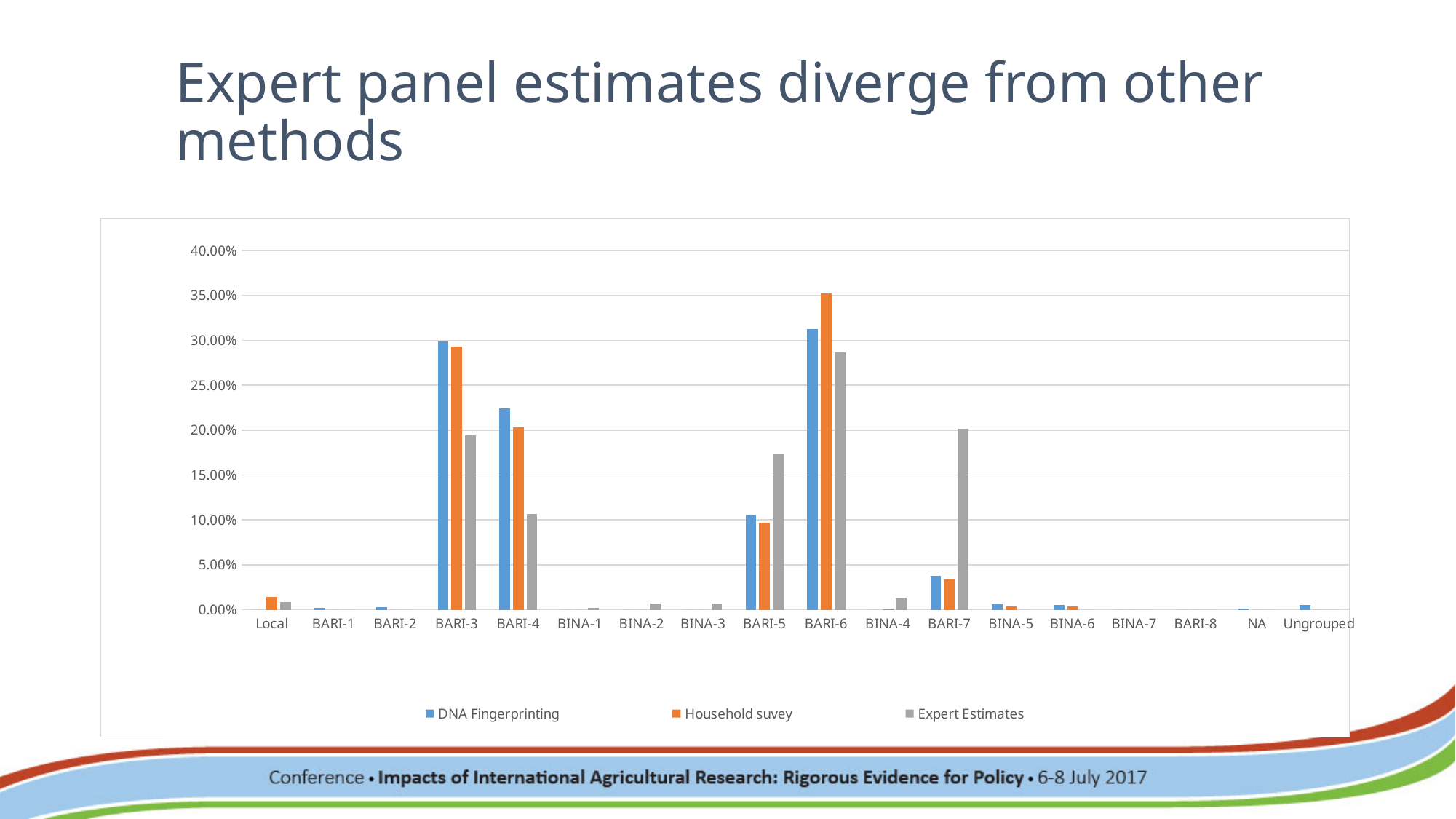
How many categories are shown on the x axis? 18 Which colour represents the Expert Estimates series in the legend? grey Which category has the highest DNA Fingerprinting value? BARI-6 Which category has the highest Household suvey value? BARI-6 How many series does the legend list? 3 Is the DNA Fingerprinting value for BARI-4 greater or less than 20.00%? greater For BARI-3, which is larger: the DNA Fingerprinting value or the Expert Estimates value? DNA Fingerprinting Which category has the highest Expert Estimates value? BARI-6 What kind of chart is shown on the slide? bar chart For BARI-7, which is larger: the Expert Estimates value or the DNA Fingerprinting value? Expert Estimates Is the Household suvey value for BARI-6 greater or less than 30.00%? greater Is the Expert Estimates value for BARI-4 greater or less than 15.00%? less